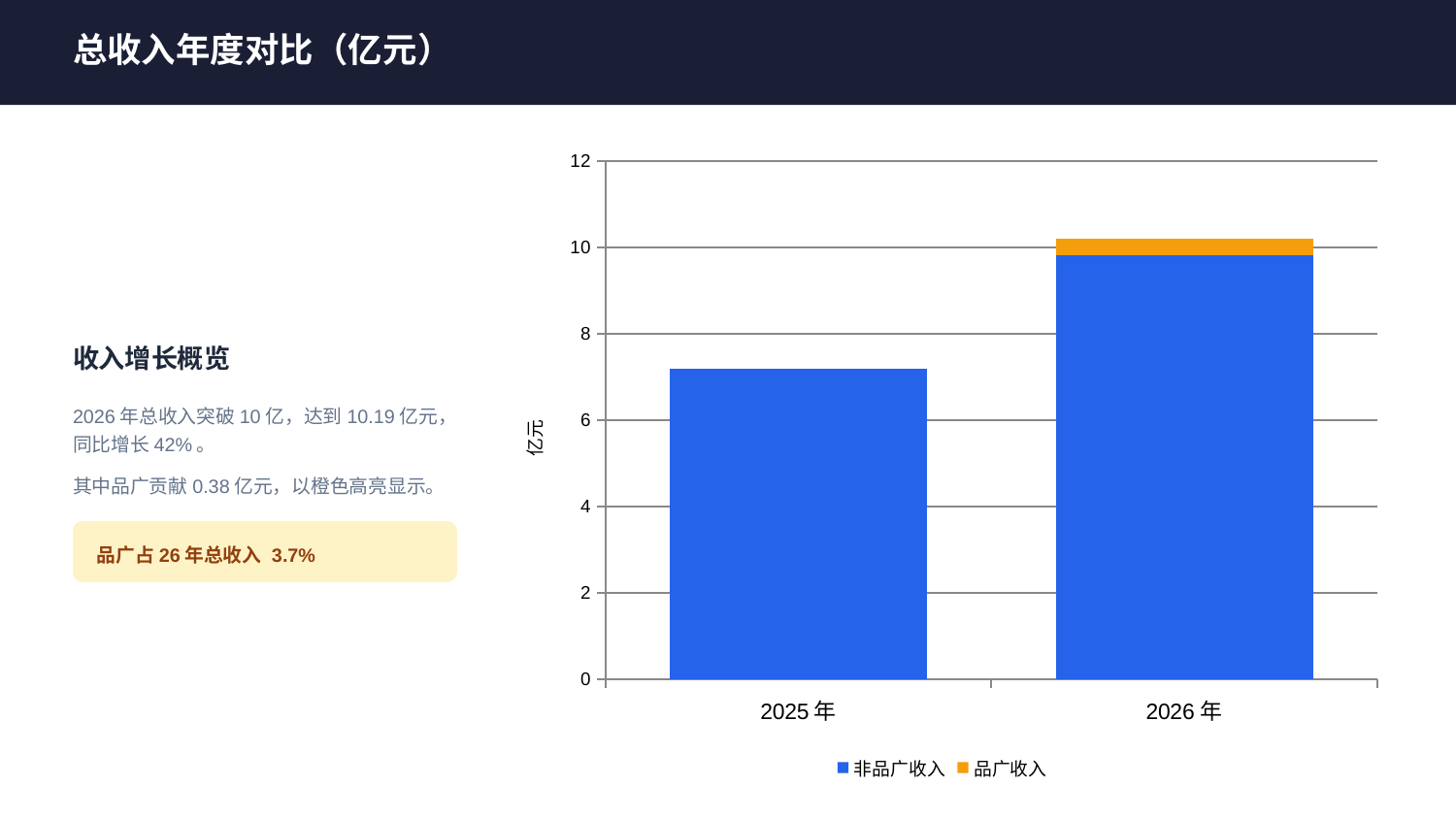
Does total revenue rise or fall from 2025 年 to 2026 年? rise Which year has the higher total revenue bar? 2026 年 Is the 非品广收入 segment for 2026 年 greater or less than 10? less What is the title of the chart slide? 总收入年度对比（亿元） What kind of chart is shown on the slide? stacked bar chart Is the total stacked bar for 2026 年 greater or less than 10? greater Is the total bar for 2025 年 greater or less than 8? less Which series is shown in orange in the legend? 品广收入 How many categories are shown on the x axis? 2 How many series does the legend list? 2 Which year has the lower total revenue bar? 2025 年